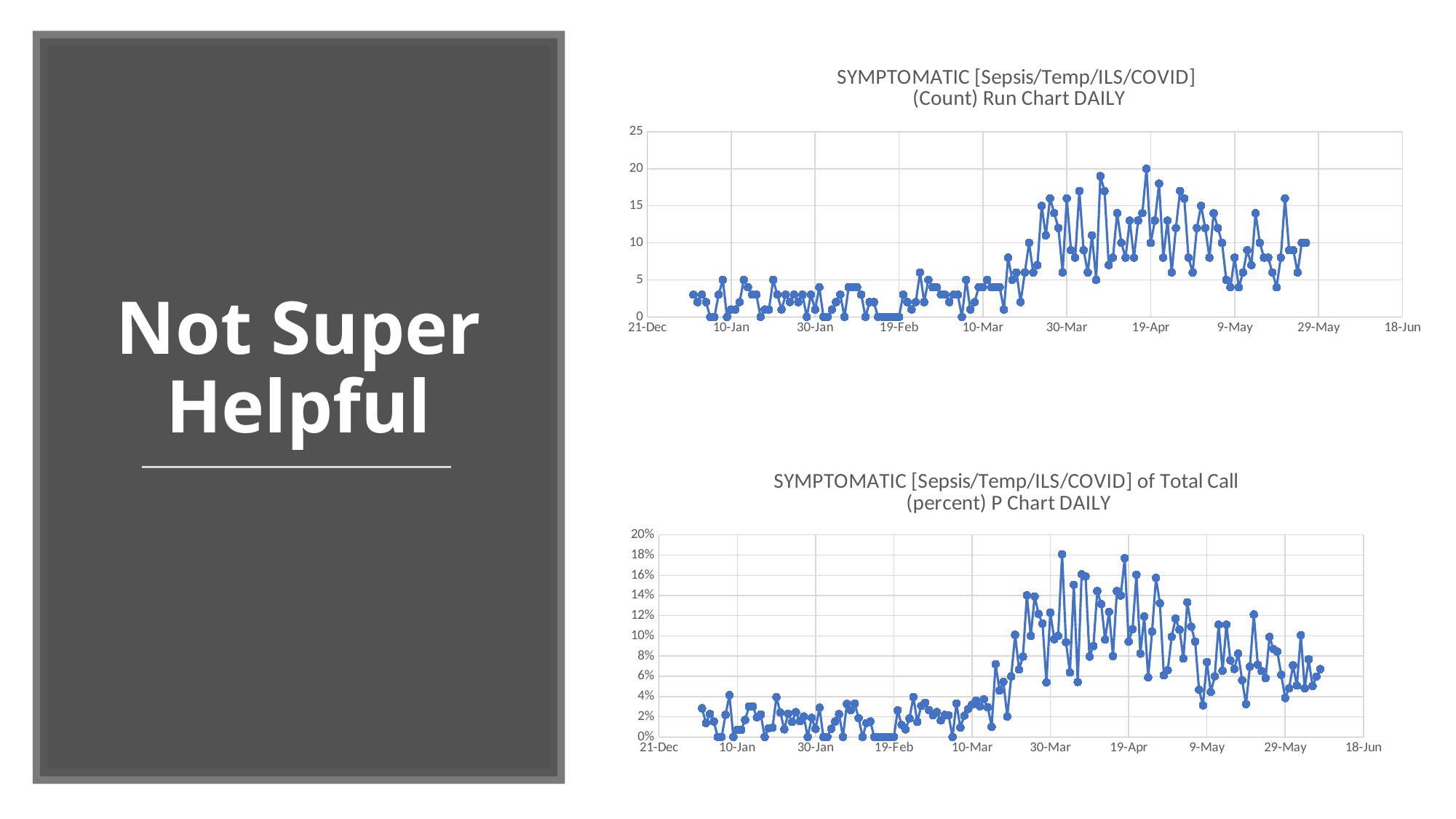
What kind of chart is the top chart, 'SYMPTOMATIC [Sepsis/Temp/ILS/COVID] (Count) Run Chart DAILY'? line chart How many charts are shown on the slide? 2 In the bottom chart (percent P Chart), do the values generally rise or fall between 10-Mar and 30-Mar? rise What kind of chart is the bottom chart, 'SYMPTOMATIC [Sepsis/Temp/ILS/COVID] of Total Call (percent) P Chart DAILY'? line chart In the top chart (Count Run Chart), are the values plotted during January greater or less than 10? less In the top chart (Count Run Chart), do the values generally rise or fall between 10-Mar and 30-Mar? rise In the bottom chart (percent P Chart), are the values plotted during January greater or less than 6%? less In the top chart (Count Run Chart), what is the first date label on the x axis? 21-Dec In the top chart (Count Run Chart), is the highest plotted value greater or less than 15? greater In the bottom chart (percent P Chart), what is the highest value shown on the y axis? 20% What is the title of the top chart on the slide? SYMPTOMATIC [Sepsis/Temp/ILS/COVID] (Count) Run Chart DAILY